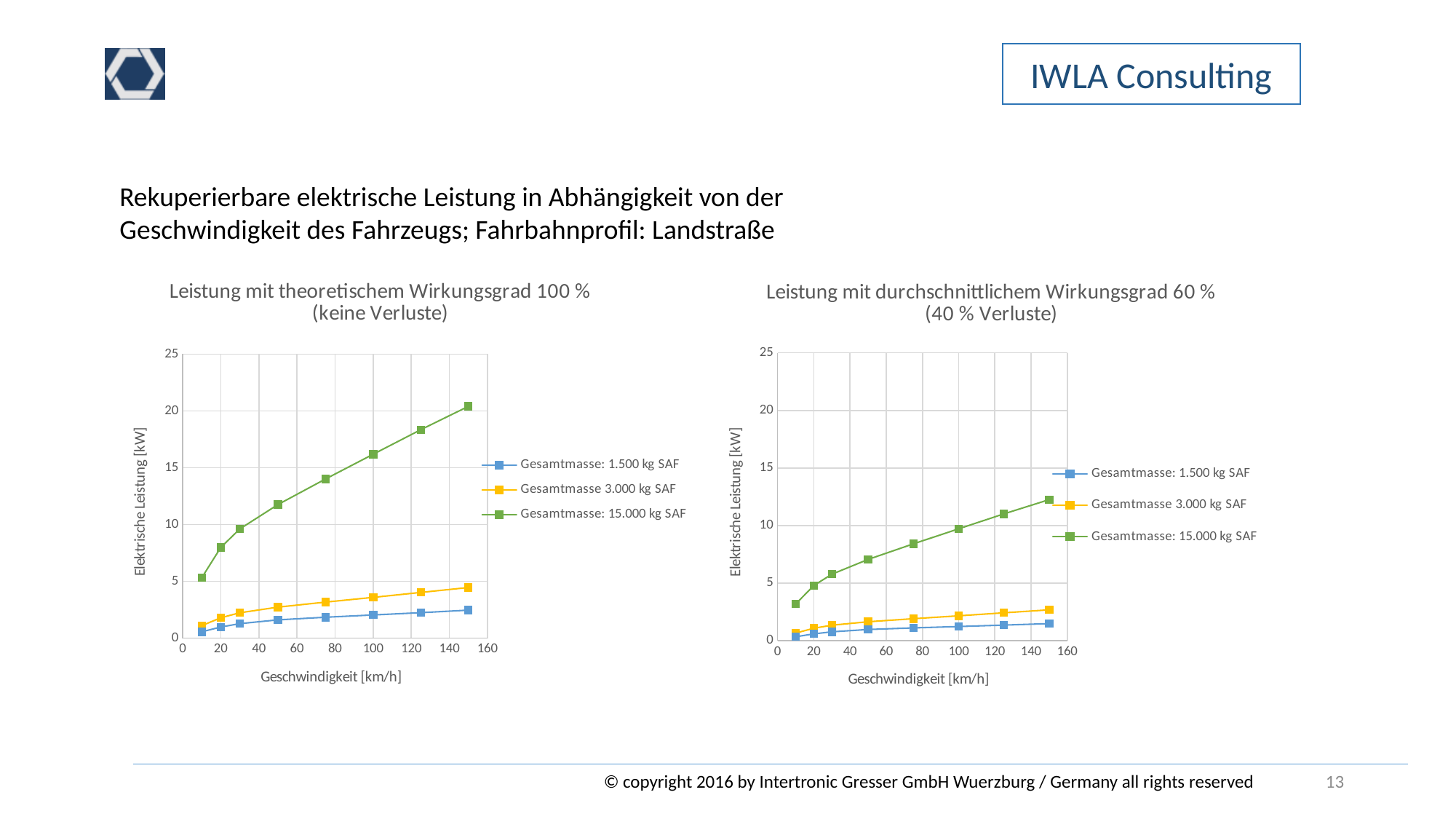
In the right chart (Wirkungsgrad 60 %), is the value for 'Gesamtmasse: 15.000 kg SAF' at 150 km/h greater or less than 10? greater What kind of chart is the left chart, 'Leistung mit theoretischem Wirkungsgrad 100 % (keine Verluste)'? line chart In the left chart (Wirkungsgrad 100 %), is the value for 'Gesamtmasse 3.000 kg SAF' at 150 km/h greater or less than 5? less In the right chart (Wirkungsgrad 60 %), is the value for 'Gesamtmasse: 15.000 kg SAF' at 10 km/h greater or less than 5? less Which is larger at 100 km/h: the 'Gesamtmasse: 15.000 kg SAF' value in the left chart (Wirkungsgrad 100 %) or in the right chart (Wirkungsgrad 60 %)? left chart (Wirkungsgrad 100 %) How many data points does the 'Gesamtmasse: 15.000 kg SAF' series have in the left chart (Wirkungsgrad 100 %)? 8 In the left chart (Wirkungsgrad 100 %), which series has the highest values across the speed range? Gesamtmasse: 15.000 kg SAF How many series does the legend of the right chart, 'Leistung mit durchschnittlichem Wirkungsgrad 60 % (40 % Verluste)', list? 3 In the left chart (Wirkungsgrad 100 %), do the values of the 'Gesamtmasse: 15.000 kg SAF' series rise or fall as Geschwindigkeit increases? rise What is the label of the y axis in the right chart (Wirkungsgrad 60 %)? Elektrische Leistung [kW] In the right chart (Wirkungsgrad 60 %), which series has the lowest values across the speed range? Gesamtmasse: 1.500 kg SAF